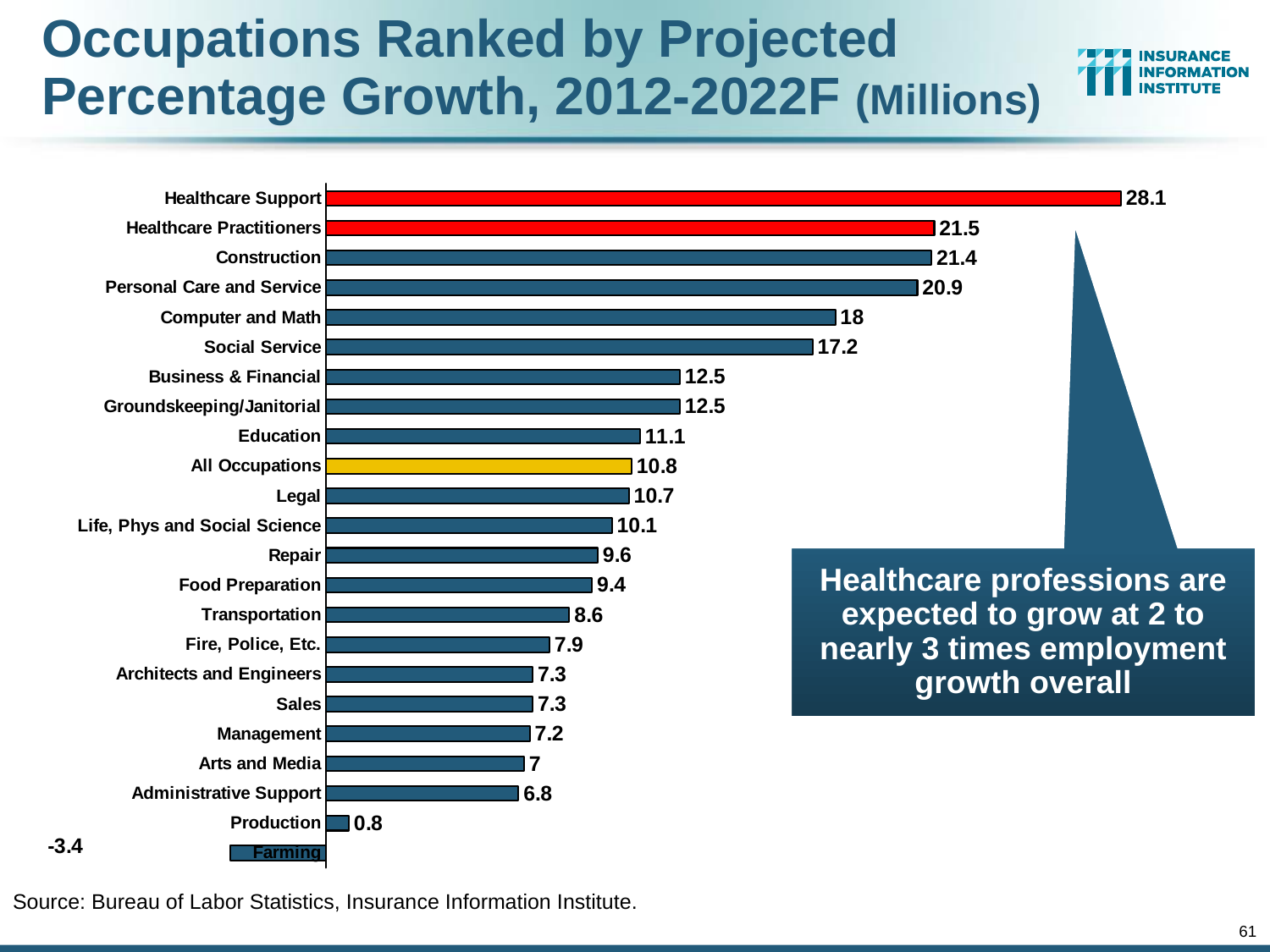
Which is larger, the value for Construction or the value for Personal Care and Service? Construction What is the value for All Occupations? 10.8 What is the difference between Social Service and Education? 6.1 What kind of chart is shown on the slide? Bar chart Which occupation has the lowest value? Farming Which occupation has the highest value? Healthcare Support What is the value for Healthcare Support? 28.1 What is the value for Farming? -3.4 How many occupation categories are shown in the chart? 23 Which bar is coloured yellow in the chart? All Occupations What is the difference between Healthcare Support and Healthcare Practitioners? 6.6 What is the value for Computer and Math? 18